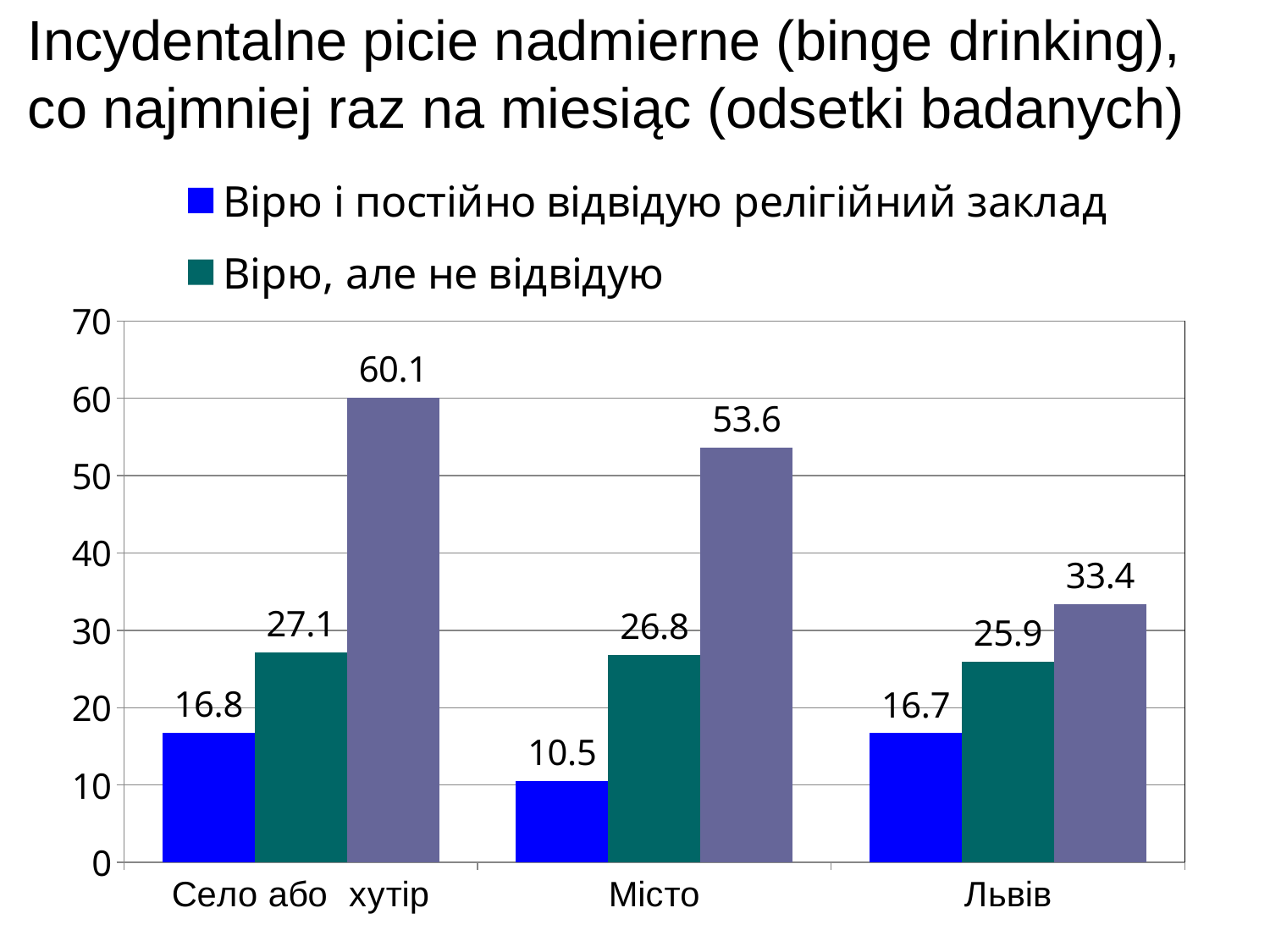
What is the difference between the grey-purple bar values for Село або хутір and Львів? 26.7 What is the difference between the two legend series for Місто ("Вірю, але не відвідую" minus "Вірю і постійно відвідую релігійний заклад")? 16.3 What kind of chart is shown on the slide? bar chart What is the value of the tallest (grey-purple, unlabelled) bar for Село або хутір? 60.1 Which is larger for Львів: the value for "Вірю і постійно відвідую релігійний заклад" or for "Вірю, але не відвідую"? Вірю, але не відвідую Which category has the highest value among the grey-purple (unlabelled) bars? Село або хутір What is the value for Місто in the series "Вірю і постійно відвідую релігійний заклад"? 10.5 What is the value for Львів in the series "Вірю, але не відвідую"? 25.9 Which category has the lowest value in the series "Вірю і постійно відвідую релігійний заклад"? Місто Is the grey-purple bar value for Місто greater or less than 50? greater How many series does the legend list? 2 How many categories are shown on the x axis? 3